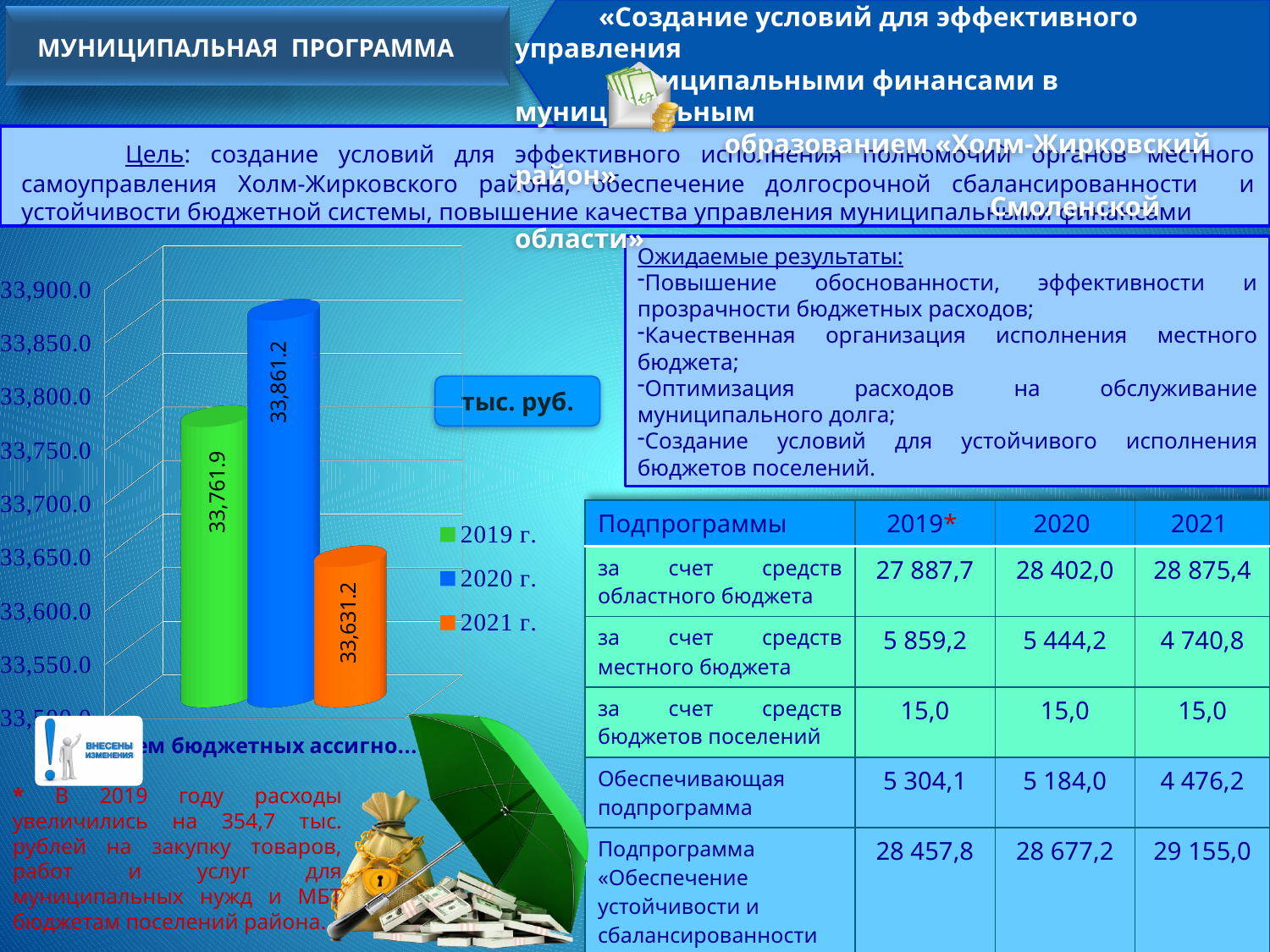
What is the value for 2021 г. in the bar chart? 33,631.2 Which year has the lowest value in the bar chart? 2021 г. Which is larger in the bar chart, the value for 2019 г. or the value for 2021 г.? 2019 г. Is the value for 2020 г. in the bar chart greater or less than 33,850.0? greater How many bars are plotted in the bar chart? 3 What is the difference between the values for 2019 г. and 2021 г. in the bar chart? 130.7 What is the value for 2019 г. in the bar chart? 33,761.9 What unit is shown in the label next to the bar chart? тыс. руб. Which year has the highest value in the bar chart? 2020 г. What is the value for 2020 г. in the bar chart? 33,861.2 How many entries does the legend of the bar chart list? 3 What is the difference between the values for 2020 г. and 2019 г. in the bar chart? 99.3